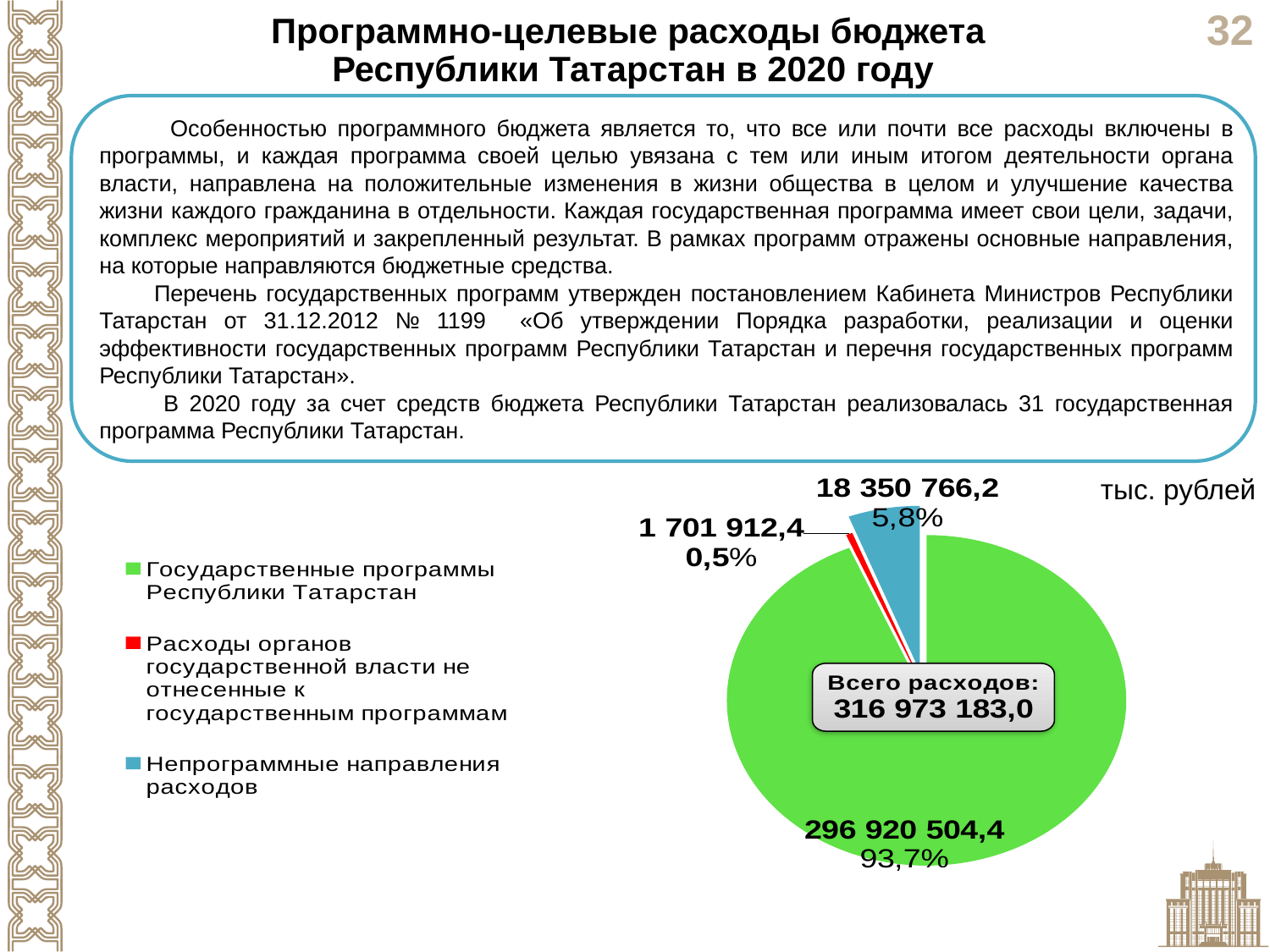
What total expenditure (Всего расходов) is shown in the centre of the pie chart? 316 973 183,0 What is the value for Непрограммные направления расходов in the pie chart? 18 350 766,2 What kind of chart is shown on the slide? pie chart What share of the pie does Непрограммные направления расходов take? 5,8% What is the value for Расходы органов государственной власти не отнесенные к государственным программам in the pie chart? 1 701 912,4 What share of the pie does Государственные программы Республики Татарстан take? 93,7% How many slices does the pie chart have? 3 Which category has the largest slice in the pie chart? Государственные программы Республики Татарстан What share of the pie does Расходы органов государственной власти не отнесенные к государственным программам take? 0,5% Which category has the smallest slice in the pie chart? Расходы органов государственной власти не отнесенные к государственным программам How many entries does the legend of the pie chart list? 3 What is the value for Государственные программы Республики Татарстан in the pie chart? 296 920 504,4